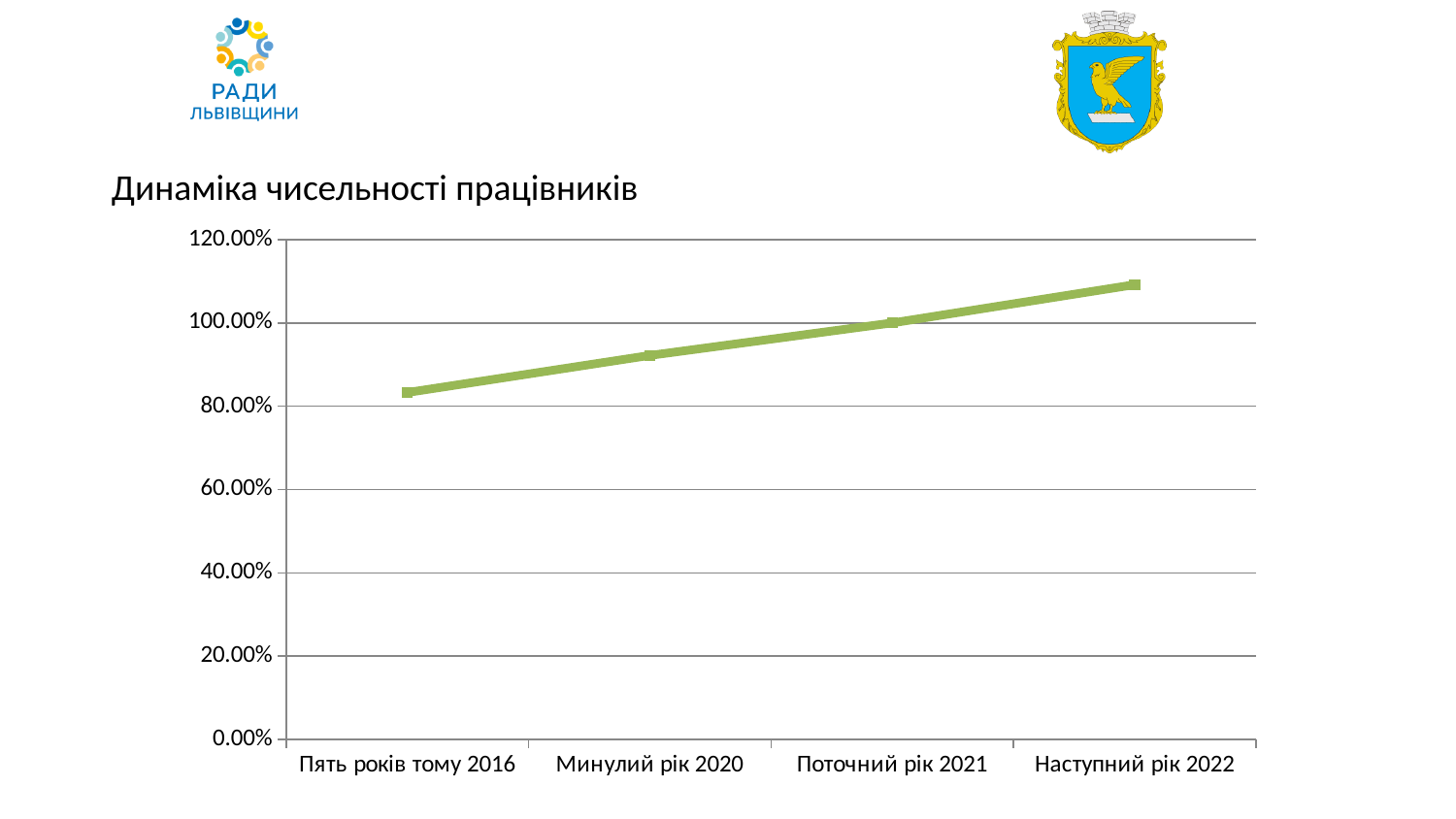
Do the values rise or fall from left to right along the x axis? rise Which category has the lowest value? Пять років тому 2016 Which is larger, the value for Минулий рік 2020 or the value for Наступний рік 2022? Наступний рік 2022 How many points are plotted on the line? 4 What is the title of the chart? Динаміка чисельності працівників What kind of chart is shown on the slide? line chart Is the value for П'ять років тому 2016 greater or less than 80.00%? greater Is the value for Наступний рік 2022 greater or less than 120.00%? less Is the value for Наступний рік 2022 greater or less than 100.00%? greater Which category has the highest value? Наступний рік 2022 What is the value for Поточний рік 2021? 100.00%